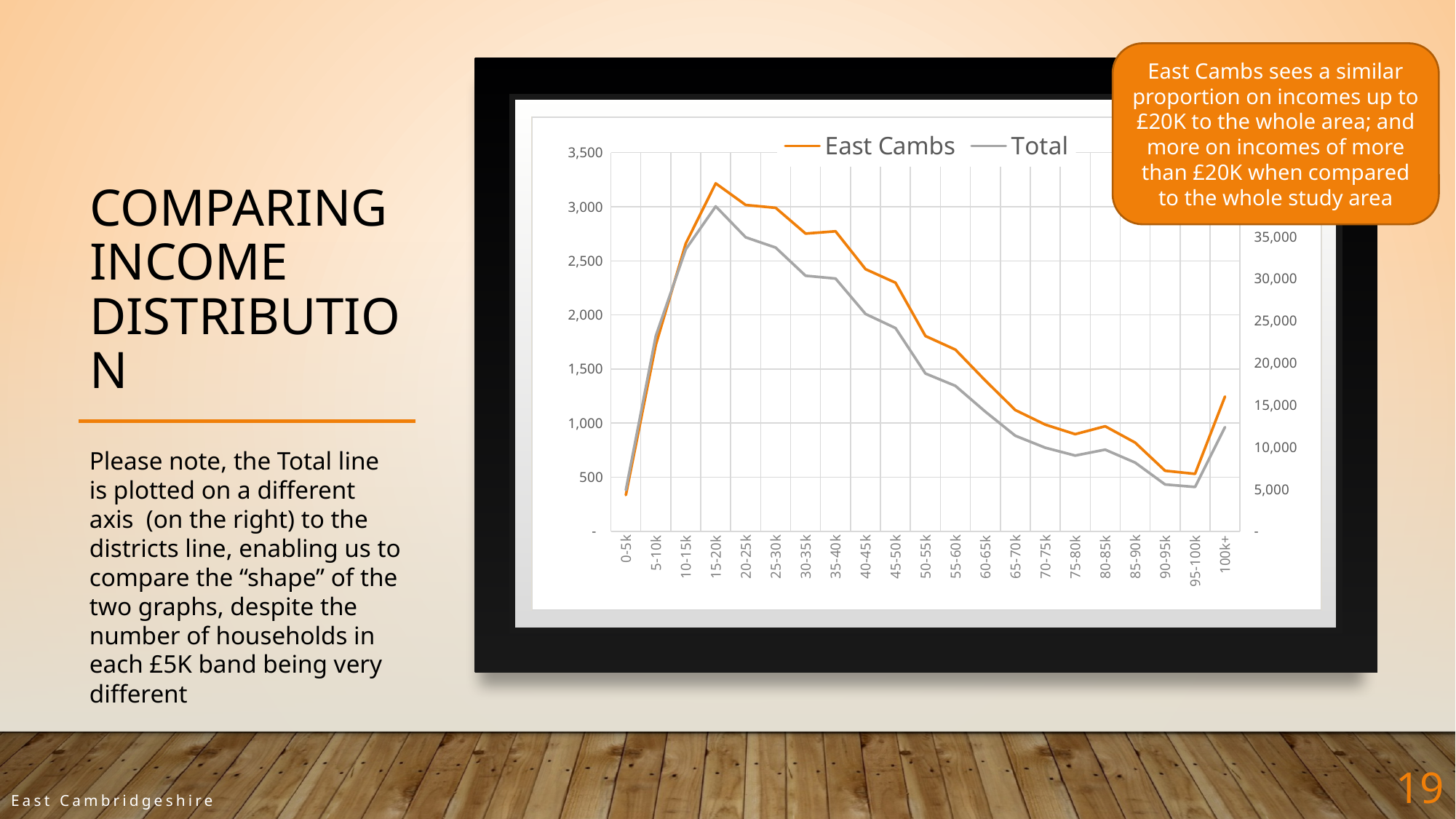
Is the East Cambs value for 15-20k greater or less than 3,000? greater What kind of chart is shown on the slide? line chart Which income band has the lowest value for the East Cambs series? 0-5k Which income band has the highest value for the Total series? 15-20k Which income band has the highest value for the East Cambs series? 15-20k Is the East Cambs value for 75-80k greater or less than 1,000? less Do the East Cambs values rise or fall from the 15-20k band to the 95-100k band? fall How many income bands are shown along the x axis of the chart? 21 For the East Cambs series, which is larger: the value for 20-25k or the value for 40-45k? 20-25k Is the East Cambs value for 100k+ greater or less than 1,000? greater How many series does the chart legend list? 2